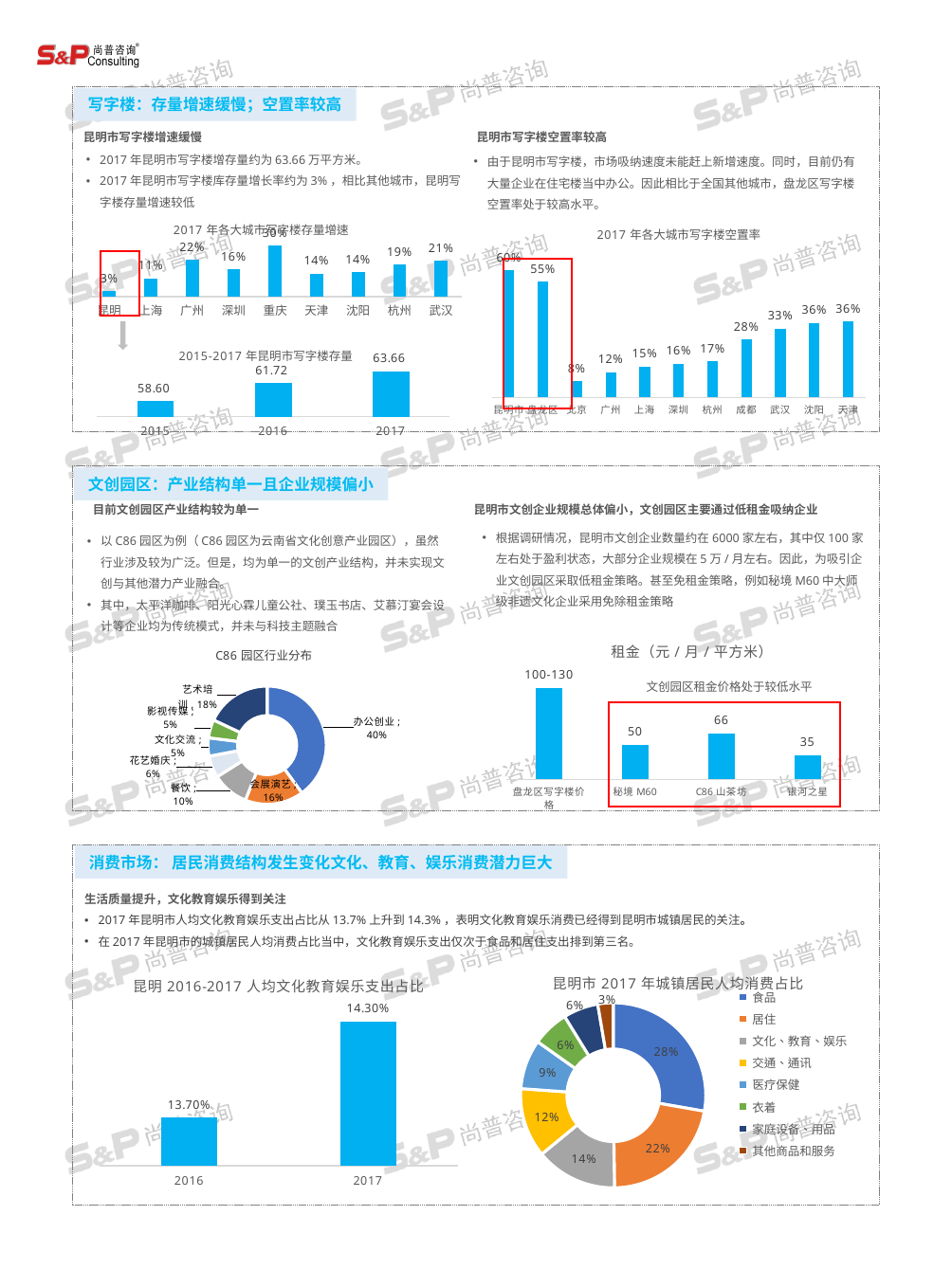
In the chart titled "租金（元/月/平方米）", what is the value for C86山茶坊? 66 In the chart titled "2017年各大城市写字楼空置率", what is the difference between 昆明市 and 盘龙区? 5% In the chart titled "2015-2017年昆明市写字楼存量", do the values rise or fall from 2015 to 2017? rise In the chart titled "昆明2016-2017人均文化教育娱乐支出占比", what is the value for 2016? 13.70% In the donut chart titled "昆明市2017年城镇居民人均消费占比", how many entries does the legend list? 8 In the chart titled "2017年各大城市写字楼增速", what is the value for 昆明? 3% In the chart titled "2017年各大城市写字楼增速", which city has the highest value? 重庆 In the chart titled "租金（元/月/平方米）", which of 秘境M60 and 银河之星 has the larger value? 秘境M60 In the chart titled "2015-2017年昆明市写字楼存量", what is the value for 2017? 63.66 In the chart titled "2017年各大城市写字楼空置率", what is the value for 北京? 8% In the donut chart titled "C86园区行业分布", what share does 办公创业 have? 40% In the chart titled "2017年各大城市写字楼空置率", how many categories are shown? 11